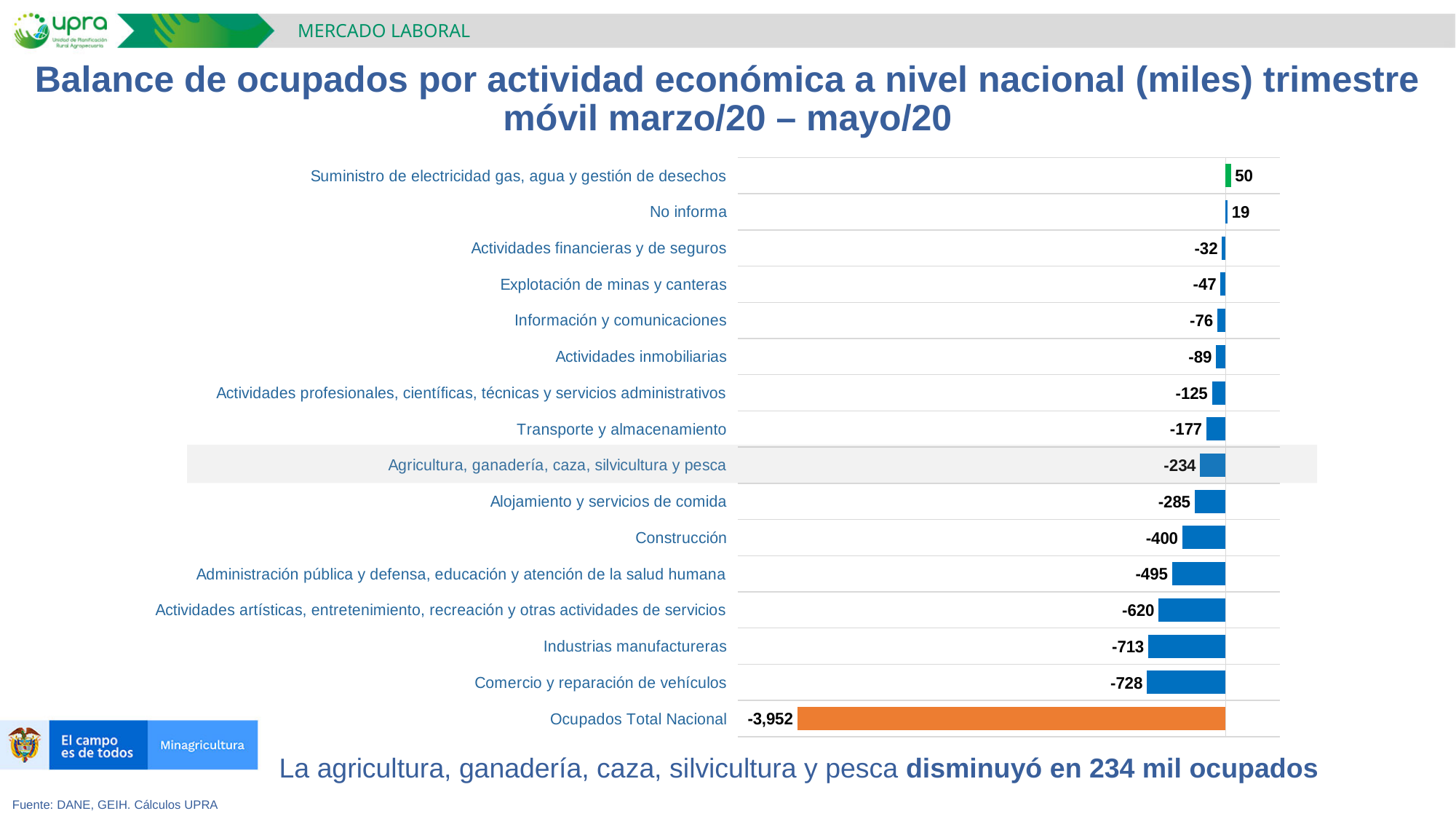
What is the value for Agricultura, ganadería, caza, silvicultura y pesca? -234 What is the difference between the values for Construcción and Alojamiento y servicios de comida? 115 What is the value for Ocupados Total Nacional? -3,952 What is the difference between the values for Industrias manufactureras and Comercio y reparación de vehículos? 15 How many categories are shown in the chart? 16 What kind of chart is shown on the slide? Bar chart What is the value for Comercio y reparación de vehículos? -728 Which is larger, the value for Transporte y almacenamiento or the value for Actividades inmobiliarias? Actividades inmobiliarias What is the value for No informa? 19 Which category has the highest value? Suministro de electricidad gas, agua y gestión de desechos Which category has the lowest value? Ocupados Total Nacional What colour is the bar for Ocupados Total Nacional? Orange